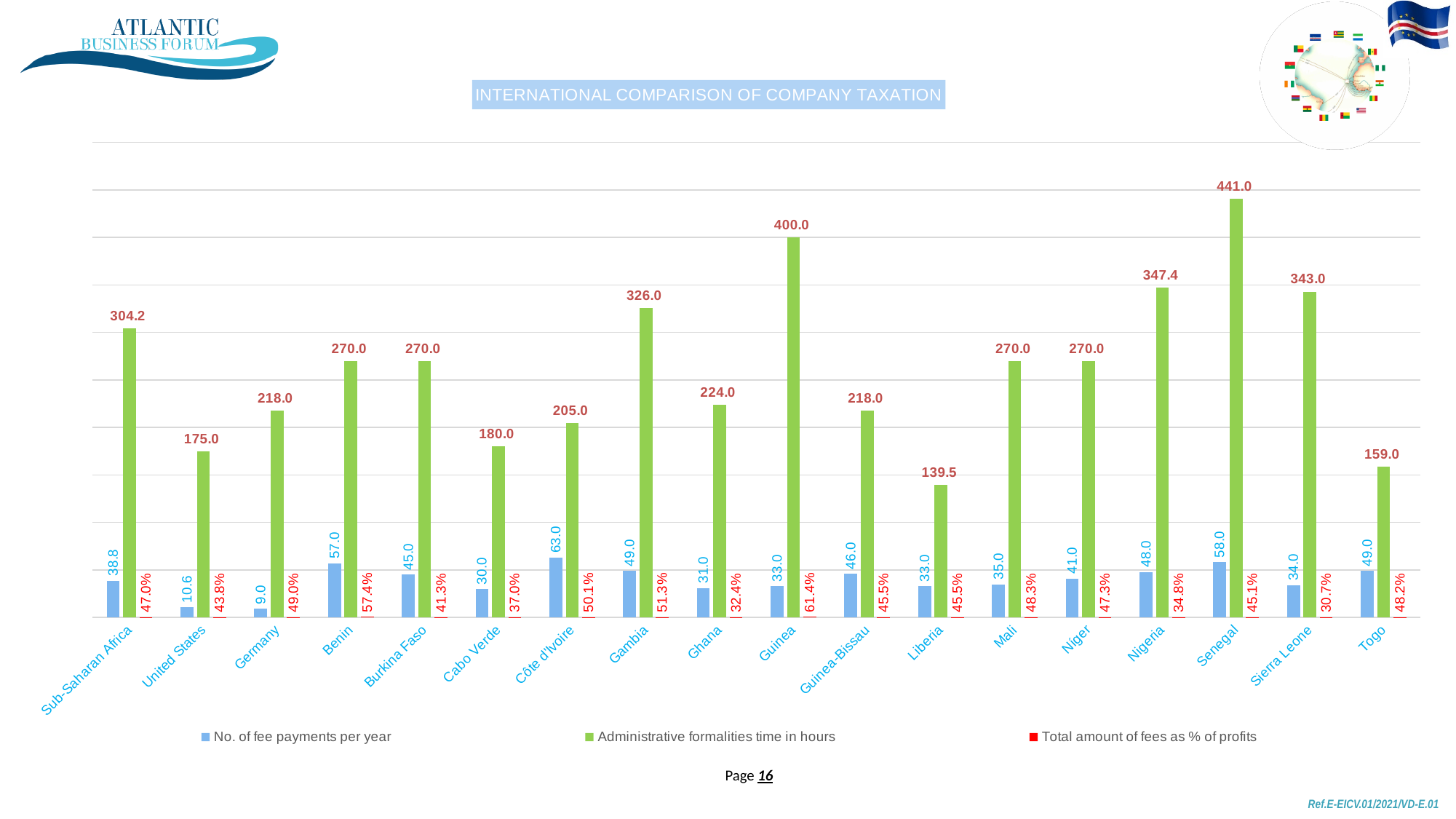
What is the difference in administrative formalities time in hours between Senegal and Guinea? 41.0 Which country has the lowest administrative formalities time in hours? Liberia What is the total amount of fees as % of profits for Guinea? 61.4% Which has a higher administrative formalities time in hours, Gambia or Ghana? Gambia How many series does the legend list? 3 Which category has the lowest number of fee payments per year? Germany What is the administrative formalities time in hours for Senegal? 441.0 What is the number of fee payments per year for Côte d'Ivoire? 63.0 Which country has the lowest total amount of fees as % of profits? Sierra Leone What kind of chart is shown on the slide? Bar chart Which country has the highest administrative formalities time in hours? Senegal How many countries or regions are shown on the x axis? 18